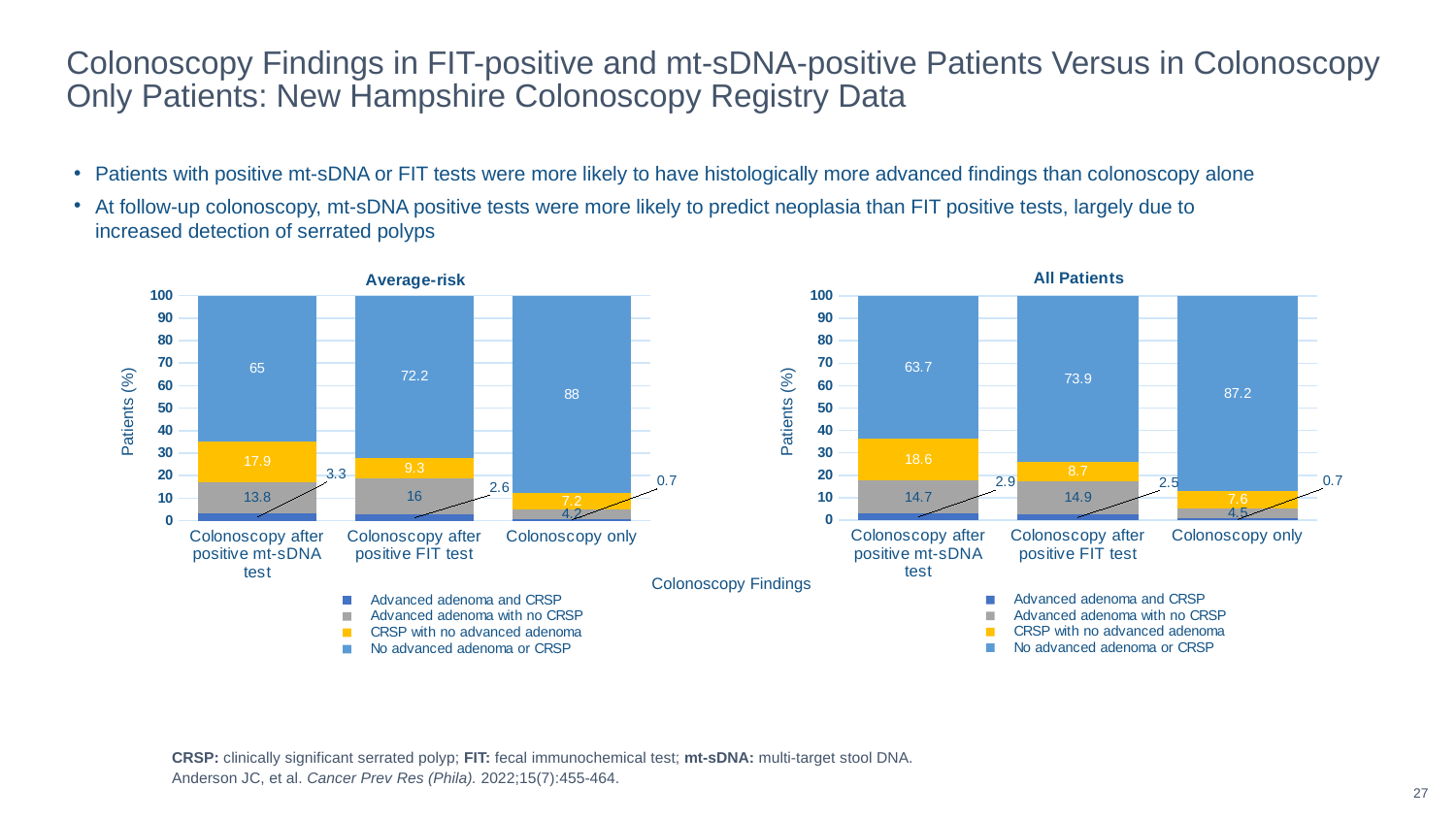
In the Average-risk chart, what is the difference between the 'No advanced adenoma or CRSP' values for the Colonoscopy only group and the Colonoscopy after positive FIT test group? 15.8 How many groups are shown on the x axis of the All Patients chart? 3 In the Average-risk chart, what is the value for 'CRSP with no advanced adenoma' in the Colonoscopy after positive mt-sDNA test group? 17.9 What kind of chart is the Average-risk chart? Stacked bar chart In the Average-risk chart, which group has the highest value for 'CRSP with no advanced adenoma'? Colonoscopy after positive mt-sDNA test In the All Patients chart, which is larger: 'CRSP with no advanced adenoma' for Colonoscopy after positive mt-sDNA test or for Colonoscopy after positive FIT test? Colonoscopy after positive mt-sDNA test In the Average-risk chart, what is the value for 'No advanced adenoma or CRSP' in the Colonoscopy only group? 88 In the All Patients chart, what is the value for 'Advanced adenoma with no CRSP' in the Colonoscopy after positive FIT test group? 14.9 In the All Patients chart, which group has the lowest value for 'No advanced adenoma or CRSP'? Colonoscopy after positive mt-sDNA test In the All Patients chart, what is the value for 'Advanced adenoma and CRSP' in the Colonoscopy after positive mt-sDNA test group? 2.9 In the All Patients chart, what is the total of the stacked bar for the Colonoscopy only group? 100 How many series does the legend of the Average-risk chart list? 4